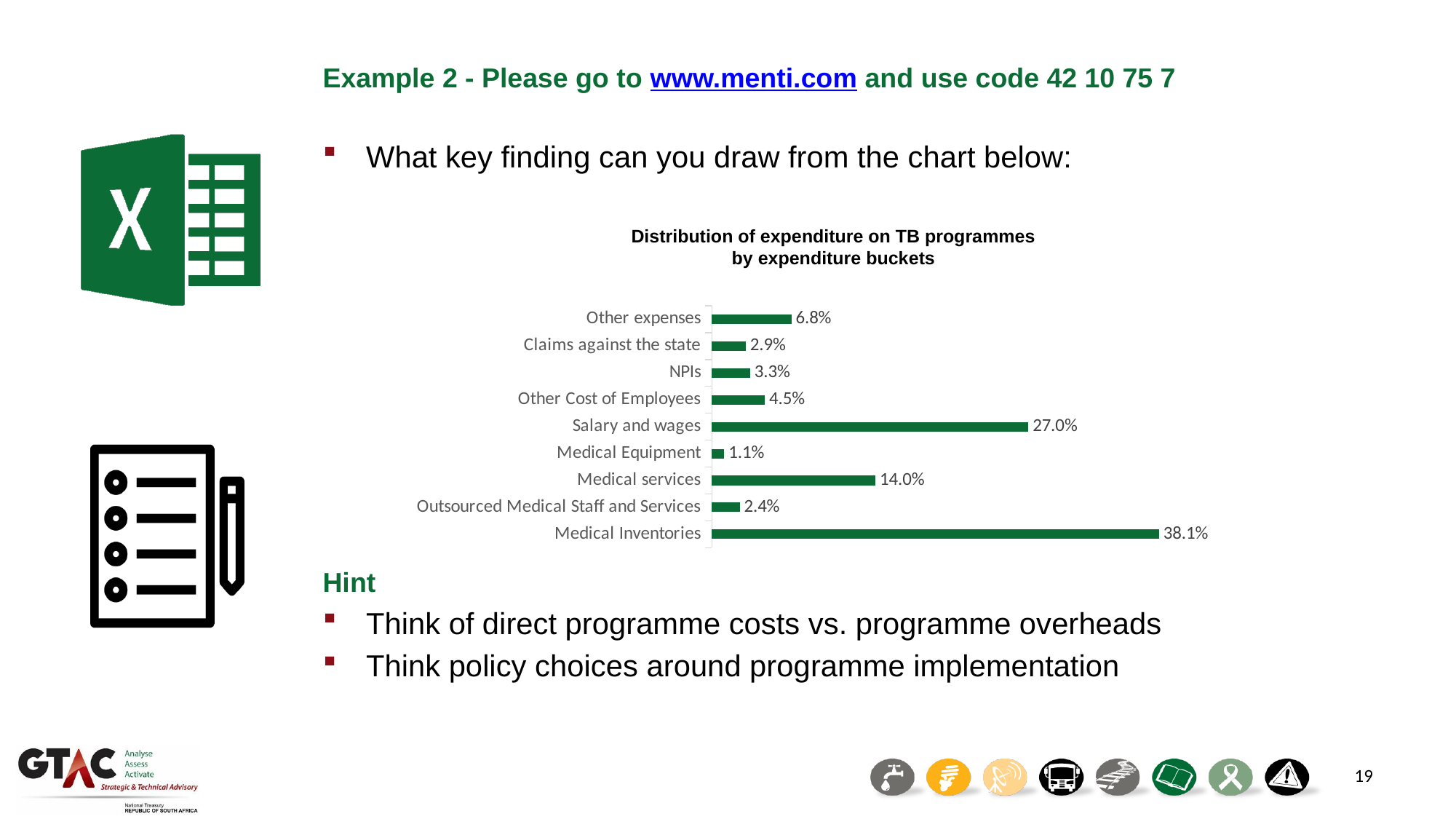
Which category has the lowest value? Medical Equipment What is the value for Medical services? 14.0% What is the value for Claims against the state? 2.9% Which is larger, Other expenses or Other Cost of Employees? Other expenses What is the value for Salary and wages? 27.0% What is the difference between Medical services and Other expenses? 7.2% What is the difference between Medical Inventories and Salary and wages? 11.1% Which category has the highest value? Medical Inventories What kind of chart is shown? Bar chart How many categories are shown in the chart? 9 What is the title of the chart? Distribution of expenditure on TB programmes by expenditure buckets What is the value for Medical Inventories? 38.1%